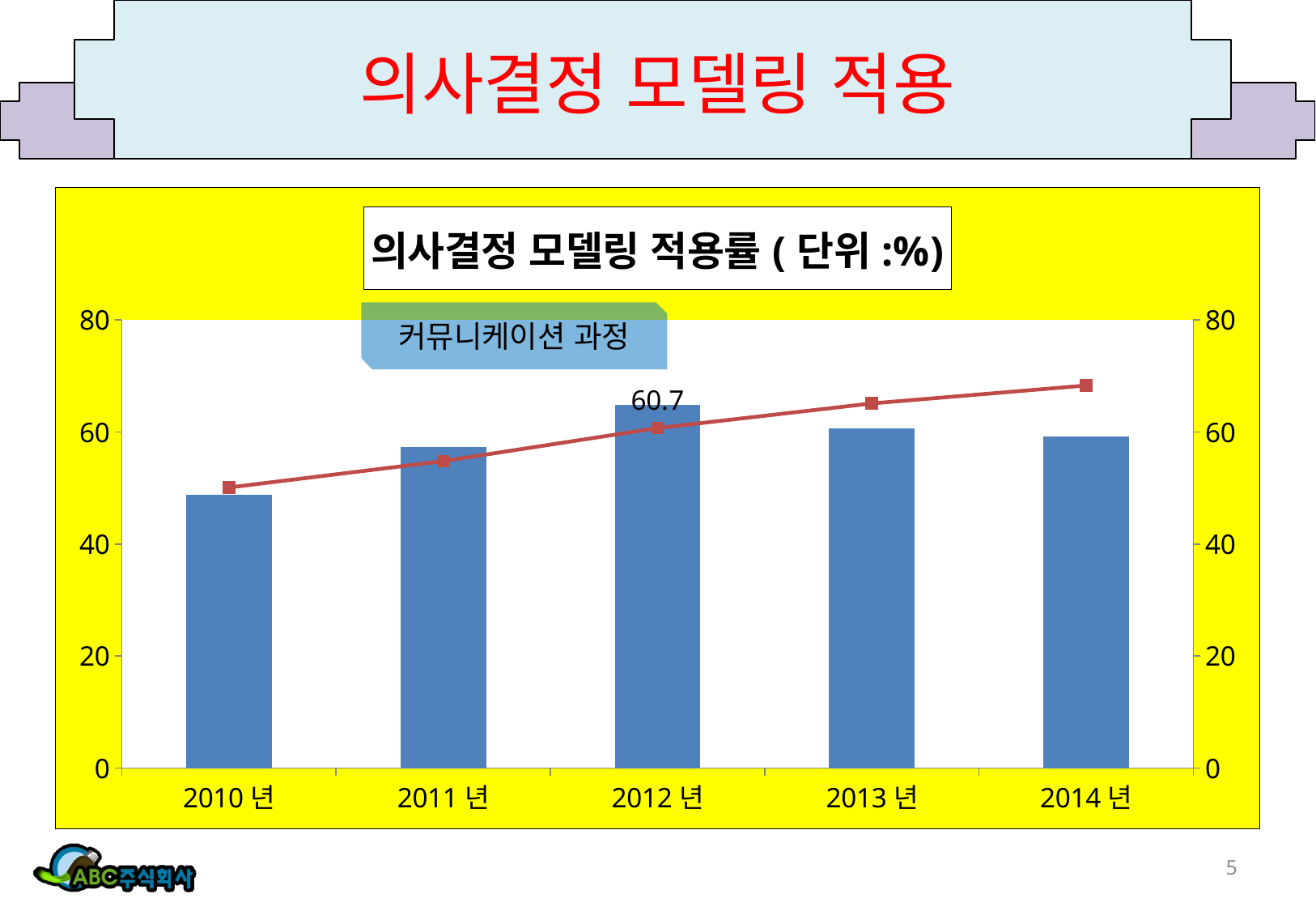
What is the highest value shown on the vertical axis of the chart? 80 Is the bar value for 2012 년 greater or less than 60? greater What kind of chart is shown on the slide? A bar chart combined with a line chart Is the bar value for 2010 년 greater or less than 60? less Which year has the tallest bar? 2012 년 Which bar is taller, 2010 년 or 2014 년? 2014 년 What value is printed as a data label on the line at 2012 년? 60.7 How many years are shown on the x axis of the chart? 5 Is the bar value for 2011 년 greater or less than 40? greater Which year has the shortest bar? 2010 년 Does the red line rise or fall from 2010 년 to 2014 년? It rises What is the title of the chart? 의사결정 모델링 적용률 ( 단위 :%)